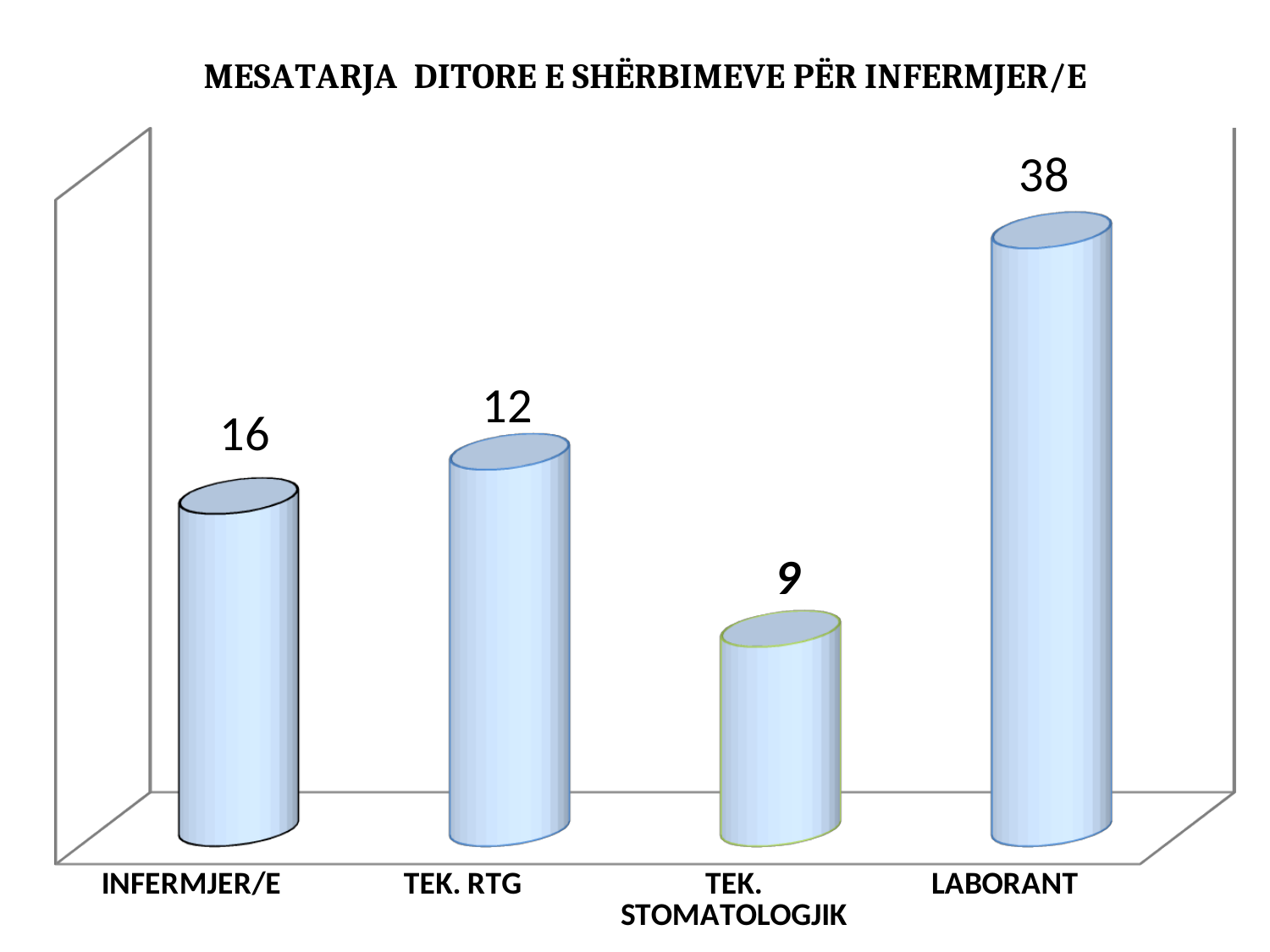
What is the value for TEK. RTG? 12 What is the value for LABORANT? 38 What is the difference between the values for LABORANT and INFERMJER/E? 22 Which is larger, the value for INFERMJER/E or the value for TEK. RTG? INFERMJER/E What is the value for TEK. STOMATOLOGJIK? 9 What is the difference between the values for TEK. RTG and TEK. STOMATOLOGJIK? 3 How many categories are shown in the chart? 4 What kind of chart is shown on the slide? Bar chart What is the title of the chart? MESATARJA DITORE E SHËRBIMEVE PËR INFERMJER/E What is the value for INFERMJER/E? 16 Which category has the highest value? LABORANT Which category has the lowest value? TEK. STOMATOLOGJIK